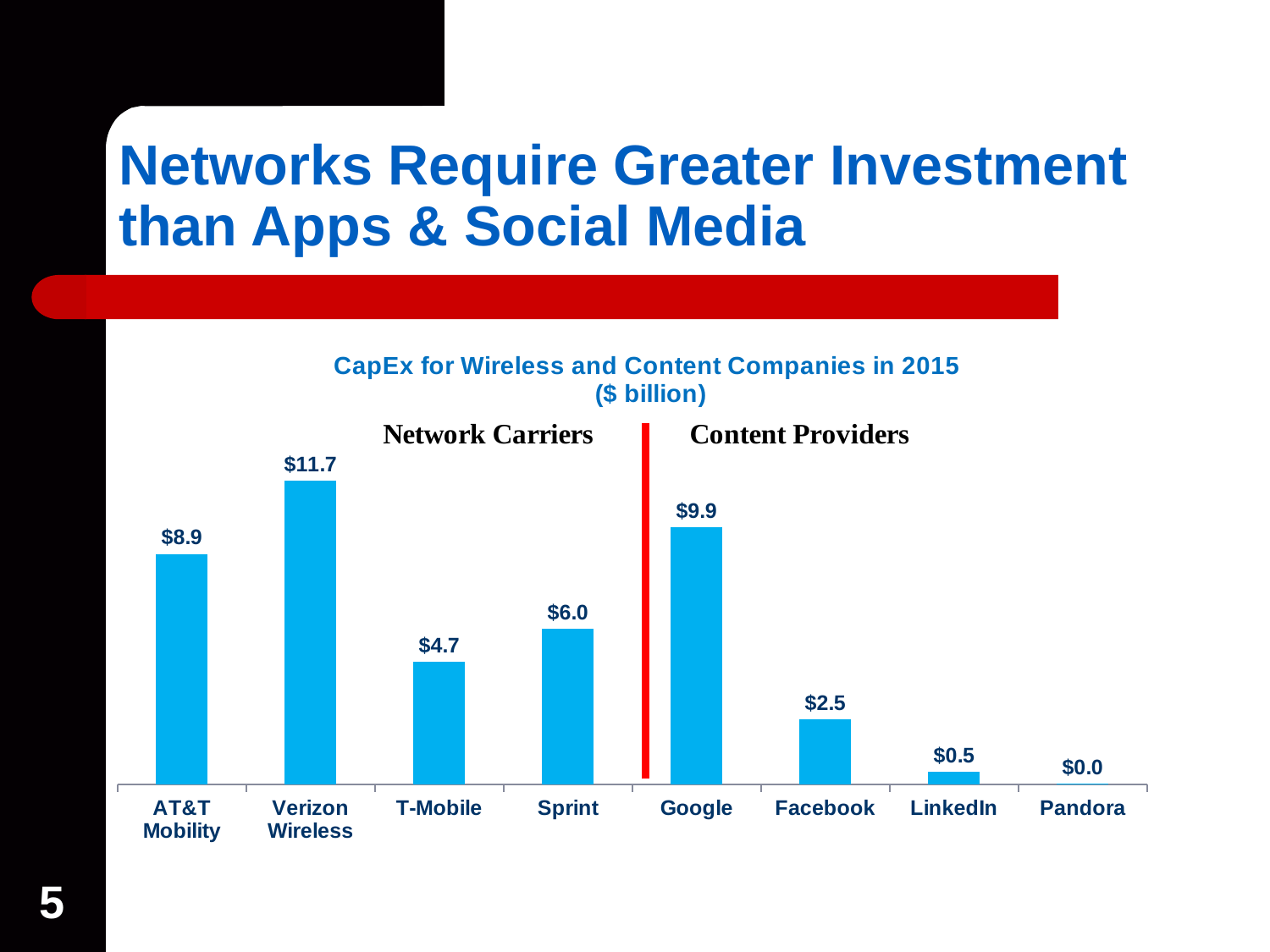
What is the CapEx value shown for T-Mobile? $4.7 Which company has the lowest CapEx in the chart? Pandora How many companies are shown in the chart? 8 What is the difference between the CapEx of Google and Facebook? $7.4 What is the difference between the CapEx of Verizon Wireless and AT&T Mobility? $2.8 What is the title of the chart? CapEx for Wireless and Content Companies in 2015 ($ billion) What is the CapEx value shown for Google? $9.9 Which company has the highest CapEx in the chart? Verizon Wireless What is the CapEx value shown for Facebook? $2.5 Which has a larger CapEx, Sprint or T-Mobile? Sprint What type of chart is shown on the slide? Bar chart What is the CapEx value shown for Verizon Wireless? $11.7